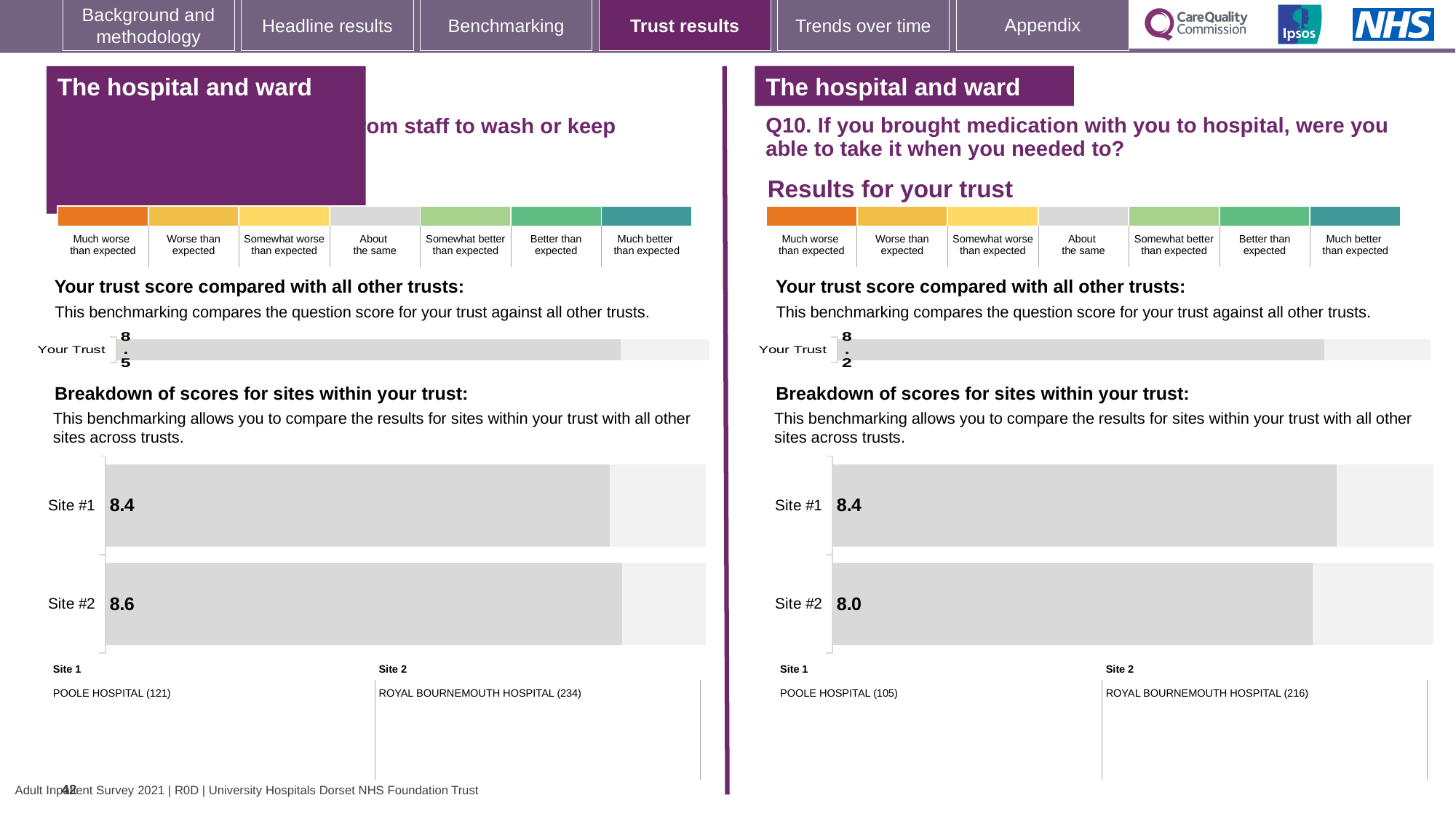
In the left-hand 'Breakdown of scores for sites within your trust' chart, what is the score for Site #2? 8.6 In the right-hand (Q10) 'Breakdown of scores for sites within your trust' chart, which site has the lower score? Site #2 How many sites are shown in the right-hand (Q10) 'Breakdown of scores for sites within your trust' chart? 2 In the left-hand 'Breakdown of scores for sites within your trust' chart, which site has the higher score? Site #2 In the right-hand (Q10) 'Breakdown of scores for sites within your trust' chart, what is the score for Site #2? 8.0 What type of chart is used for the 'Breakdown of scores for sites within your trust' on the right-hand (Q10) side? Bar chart In the left-hand site breakdown chart, what is the difference between the Site #2 and Site #1 scores? 0.2 In the right-hand (Q10) site breakdown chart, what is the difference between the Site #1 and Site #2 scores? 0.4 On the right-hand (Q10) side of the slide, what is the score shown for Your Trust in the 'Your trust score compared with all other trusts' chart? 8.2 According to the site key under the right-hand (Q10) chart, which hospital is Site 2? ROYAL BOURNEMOUTH HOSPITAL (216) In the right-hand (Q10) 'Breakdown of scores for sites within your trust' chart, what is the score for Site #1? 8.4 On the left-hand side of the slide, what is the score shown for Your Trust in the 'Your trust score compared with all other trusts' chart? 8.5